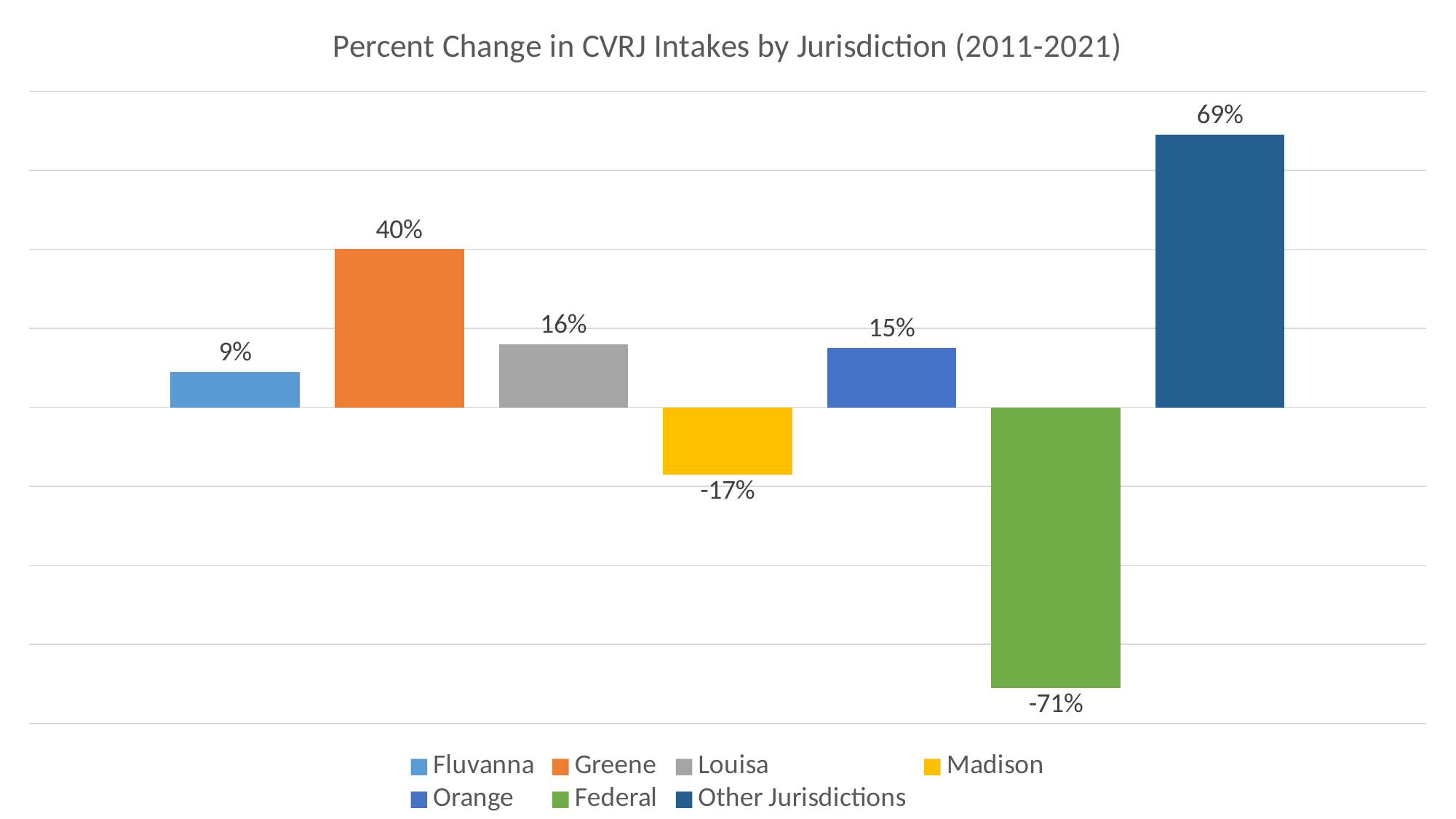
What is the percent change in CVRJ intakes for Madison? -17% Which jurisdiction has the lowest percent change in CVRJ intakes? Federal What is the percent change in CVRJ intakes for Fluvanna? 9% What is the difference between the percent change for Other Jurisdictions and Greene? 29% What is the percent change in CVRJ intakes for Greene? 40% Which jurisdiction has the highest percent change in CVRJ intakes? Other Jurisdictions What colour is the bar for Madison? Yellow What type of chart is shown on the slide? Bar chart Which has a larger percent change in CVRJ intakes, Louisa or Fluvanna? Louisa What is the title of the chart? Percent Change in CVRJ Intakes by Jurisdiction (2011-2021) How many jurisdictions are shown in the chart? 7 What is the percent change in CVRJ intakes for Federal? -71%